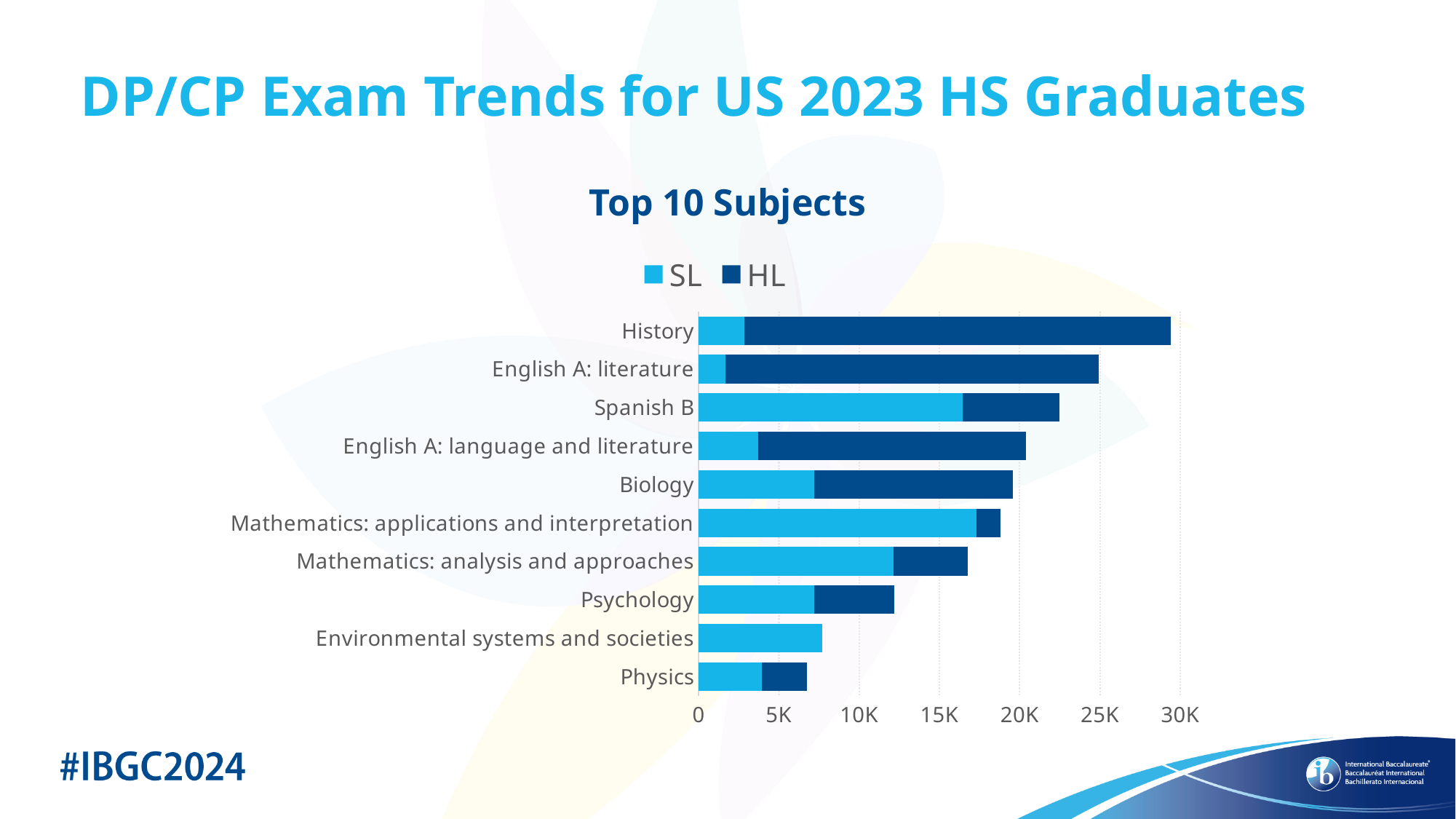
Is the total value for History greater or less than 25K? greater What is the title of the chart? Top 10 Subjects Which subject has the lowest total number of exams? Physics Is the total value for Physics greater or less than 10K? less How many series does the legend list? 2 How many subjects are shown in the Top 10 Subjects chart? 10 Which is larger, the total for Biology or the total for Psychology? Biology What kind of chart is shown on the slide? Stacked bar chart Which subject has the highest total number of exams? History Is the total value for Psychology greater or less than 10K? greater Which is larger, the SL value for Spanish B or the SL value for History? Spanish B